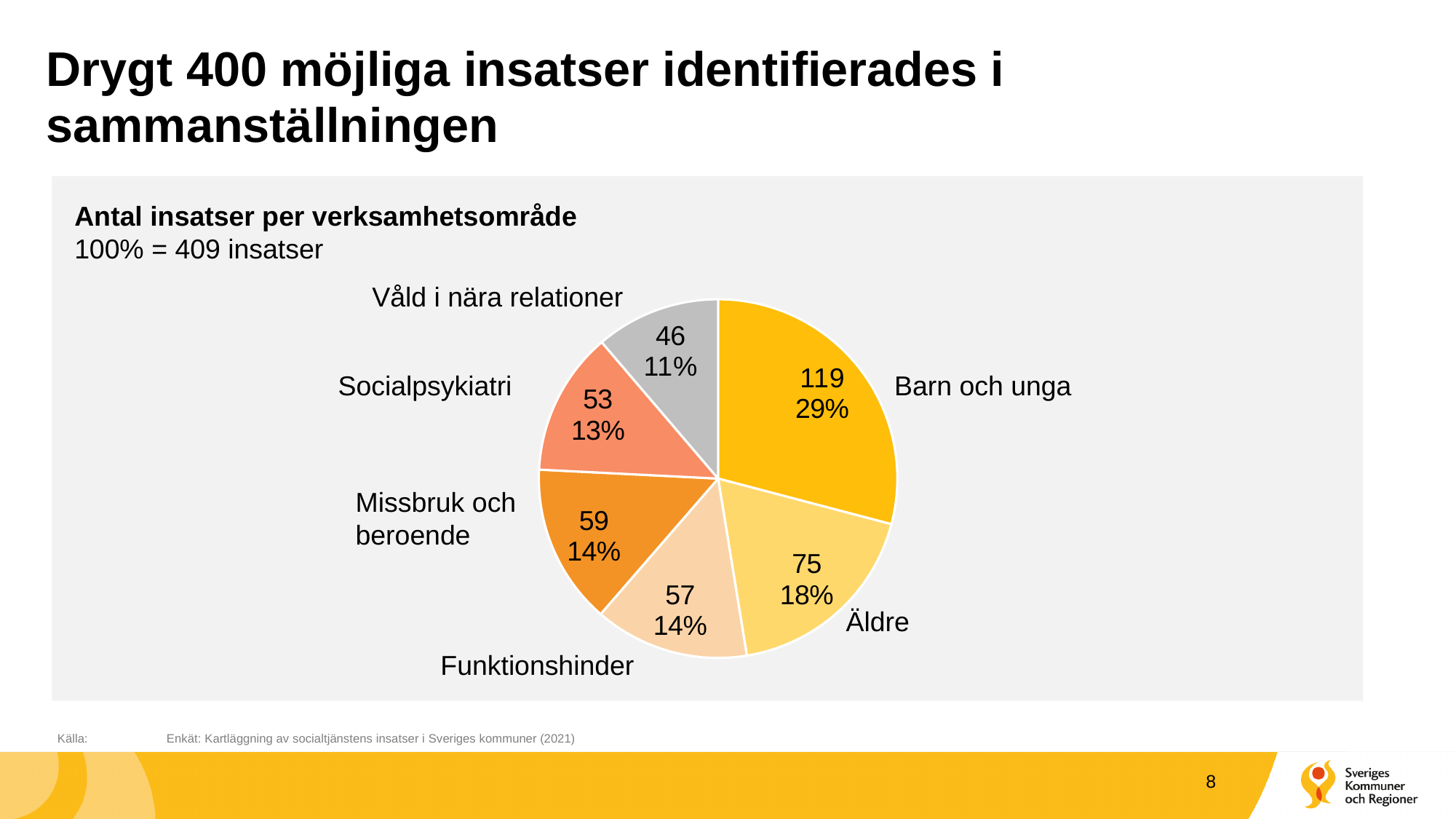
What percentage share does Äldre have in the pie chart? 18% What kind of chart is shown on the slide? pie chart Which is larger, the value for Missbruk och beroende or the value for Socialpsykiatri? Missbruk och beroende What percentage share does Funktionshinder have? 14% What is the title of the chart? Antal insatser per verksamhetsområde Which category has the largest slice of the pie? Barn och unga How many slices does the pie chart have? 6 What is the number of insatser for Barn och unga? 119 What is the difference between the values for Barn och unga and Äldre? 44 According to the chart subtitle, how many insatser correspond to 100%? 409 What is the value for Våld i nära relationer? 46 Which category has the smallest slice of the pie? Våld i nära relationer